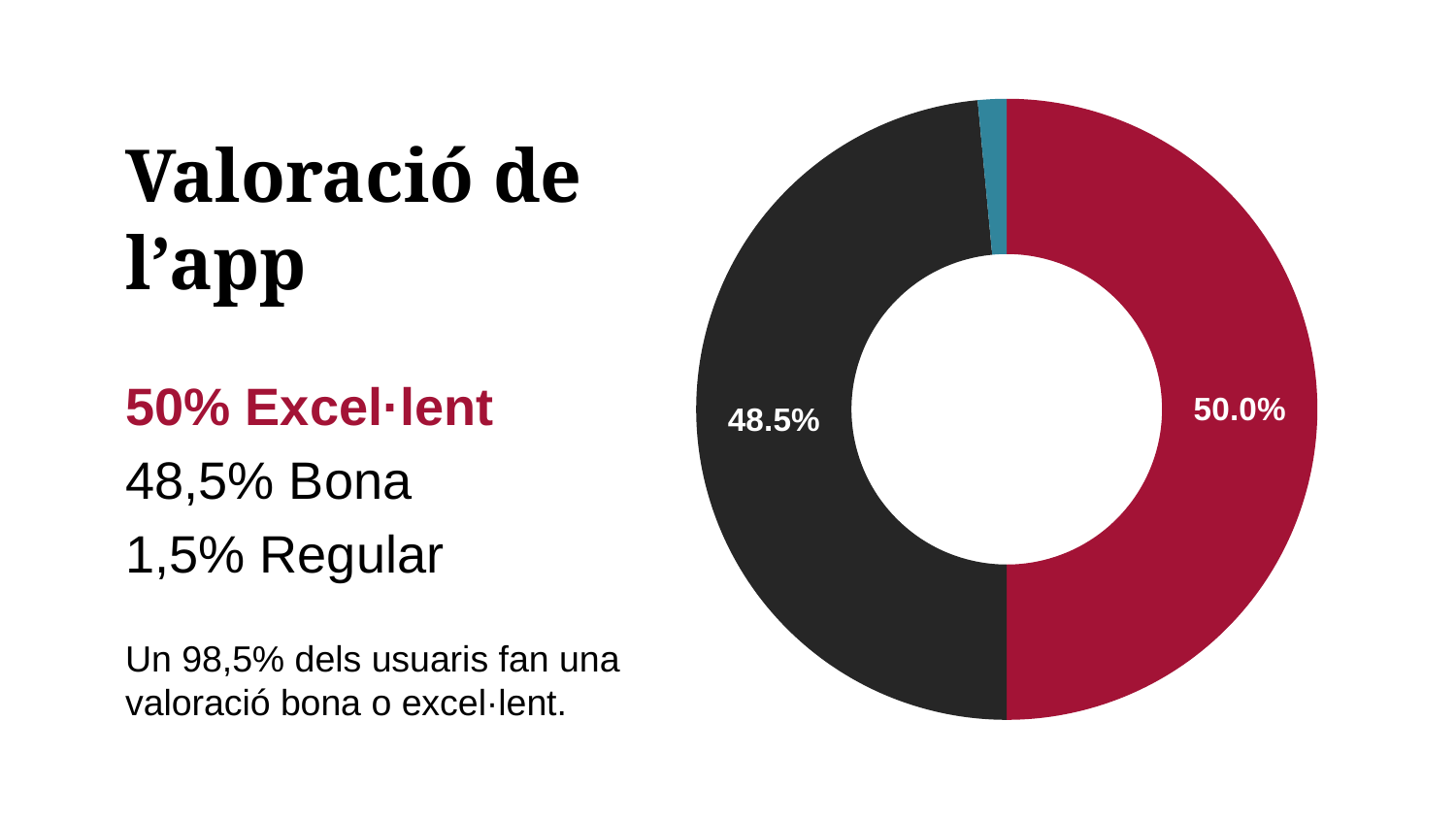
Does the chart include a legend? No What share of the whole does the red slice represent? 50.0% How many slices does the chart have? 3 What is the difference between the red slice (50.0%) and the dark slice (48.5%)? 1.5% What value is labelled on the dark (black) slice of the chart? 48.5% Which slice of the chart is the smallest? the small teal slice What kind of chart is shown on the slide? pie chart (donut) Which is larger, the red slice or the dark slice? the red slice What is the title of the slide containing the chart? Valoració de l'app According to the slide, what percentage of users rated the app Excel·lent? 50% Which slice of the chart is the largest? the red slice (50.0%) What value is labelled on the red slice of the chart? 50.0%